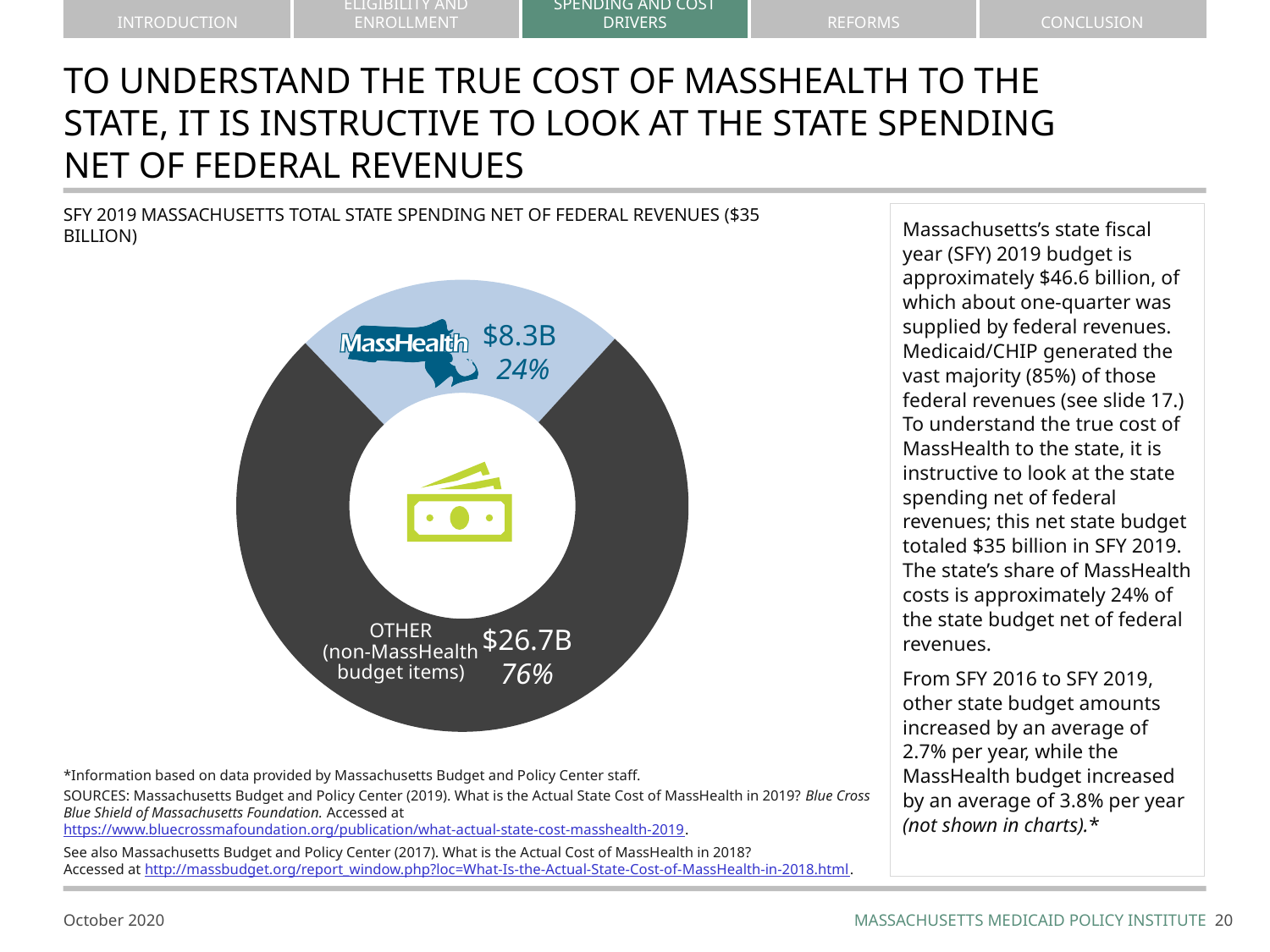
What is the title of the chart? SFY 2019 Massachusetts Total State Spending Net of Federal Revenues ($35 Billion) How many slices does the chart have? 2 What percentage share of the chart does MassHealth represent? 24% Which slice of the chart is the smallest? MassHealth What colour is the MassHealth slice of the chart? Light blue What kind of chart is shown on the slide? Pie chart (donut) What percentage share of the chart do OTHER (non-MassHealth budget items) represent? 76% Which slice of the chart is the largest? OTHER (non-MassHealth budget items) Which is larger, the MassHealth slice or the OTHER slice? OTHER What is the difference in dollars between the OTHER slice and the MassHealth slice? $18.4B What is the dollar value shown for OTHER (non-MassHealth budget items)? $26.7B What is the dollar value shown for MassHealth in the chart? $8.3B